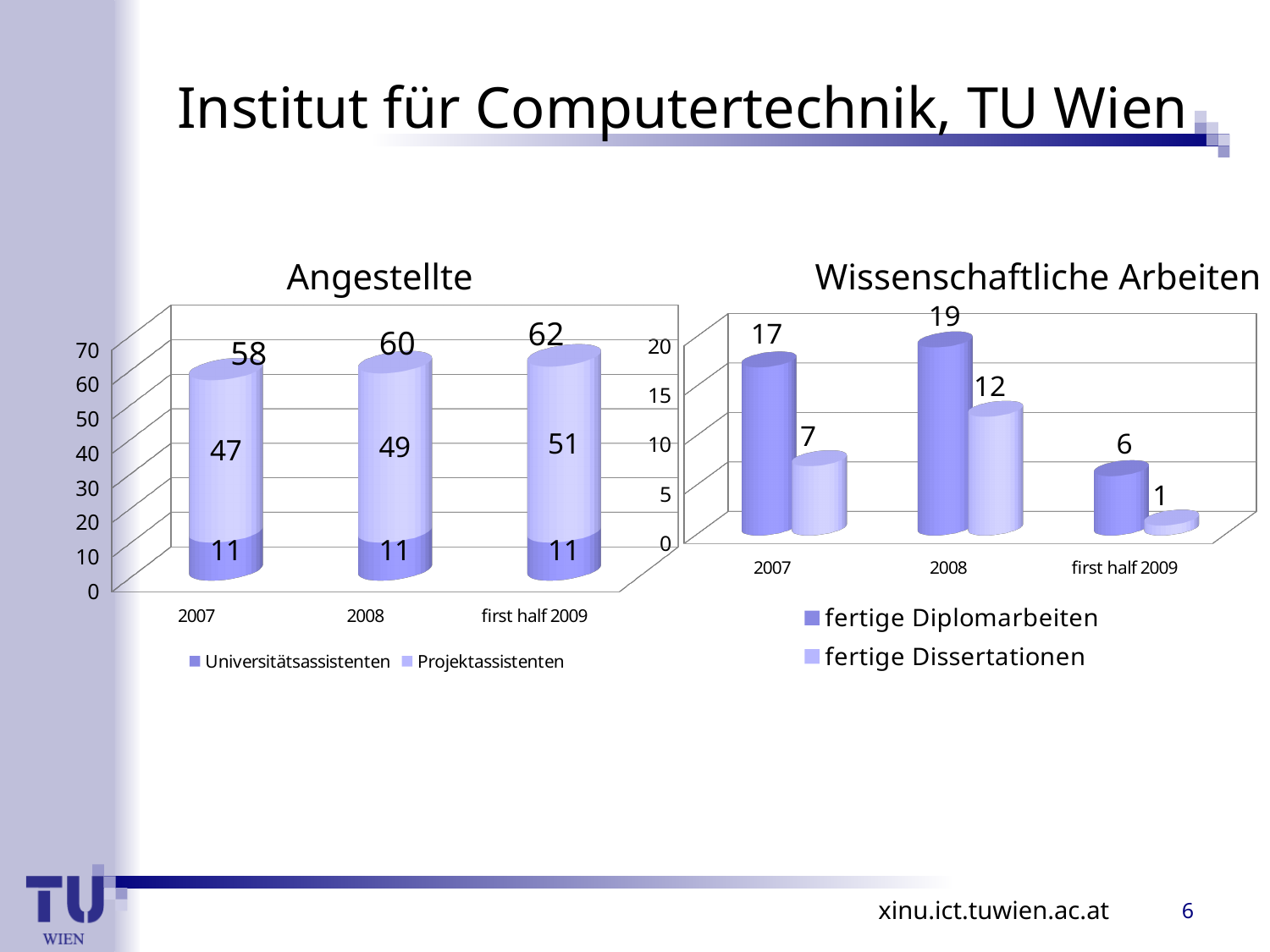
In the 'Angestellte' chart, what is the value for Universitätsassistenten in 2007? 11 What kind of chart is the 'Wissenschaftliche Arbeiten' chart? bar chart In the 'Wissenschaftliche Arbeiten' chart, which category has the highest value for fertige Diplomarbeiten? 2008 In the 'Wissenschaftliche Arbeiten' chart, what is the value for fertige Diplomarbeiten in 2008? 19 In the 'Angestellte' chart, what is the difference between the Projektassistenten values for first half 2009 and 2007? 4 In the 'Wissenschaftliche Arbeiten' chart, what is the difference between fertige Diplomarbeiten and fertige Dissertationen in 2007? 10 In the 'Angestellte' chart, how many series does the legend list? 2 In the 'Angestellte' chart, do the stacked totals rise or fall from 2007 to first half 2009? rise In the 'Wissenschaftliche Arbeiten' chart, how many categories are shown on the x axis? 3 In the 'Angestellte' chart, what is the total of the stacked bar for first half 2009? 62 In the 'Wissenschaftliche Arbeiten' chart, which category has the lowest value for fertige Dissertationen? first half 2009 In the 'Angestellte' chart, what is the value for Projektassistenten in 2008? 49